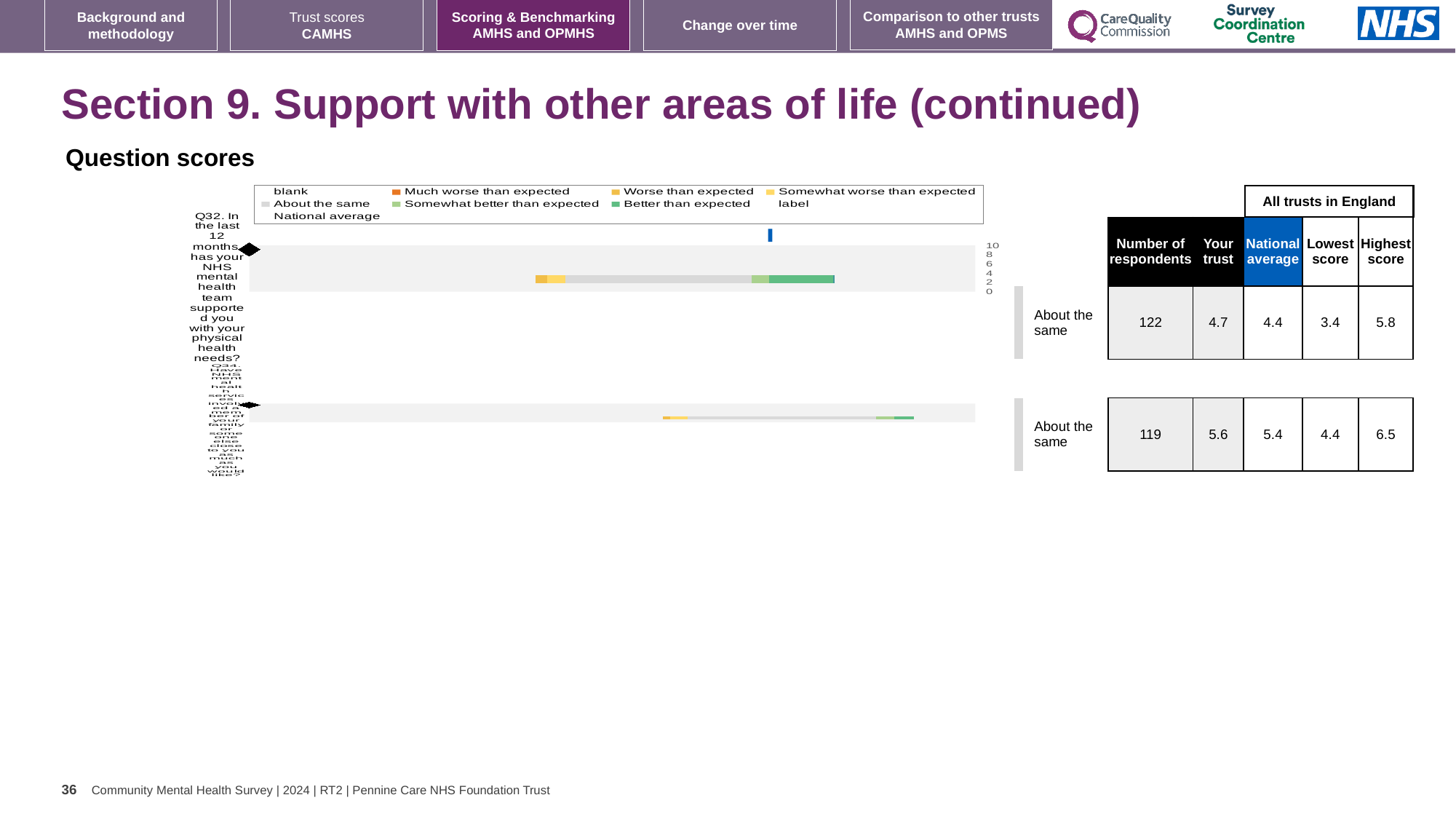
Which question has the higher 'Your trust' score, Q32 or Q34? Q34 What is the difference between the 'Your trust' score and the national average for Q32? 0.3 What kind of chart is shown under 'Question scores'? bar chart What is the highest score among all trusts in England for Q34? 6.5 How is the trust's result for Q34 described relative to other trusts? About the same What is the national average for Q32? 4.4 How many questions (categories) are plotted in the chart? 2 What is the lowest score among all trusts in England for Q32? 3.4 Which legend entry is shown in orange? Much worse than expected Which question is plotted first (at the top) in the chart? Q32 What is the number of respondents for Q32? 122 What is the 'Your trust' score for Q34? 5.6